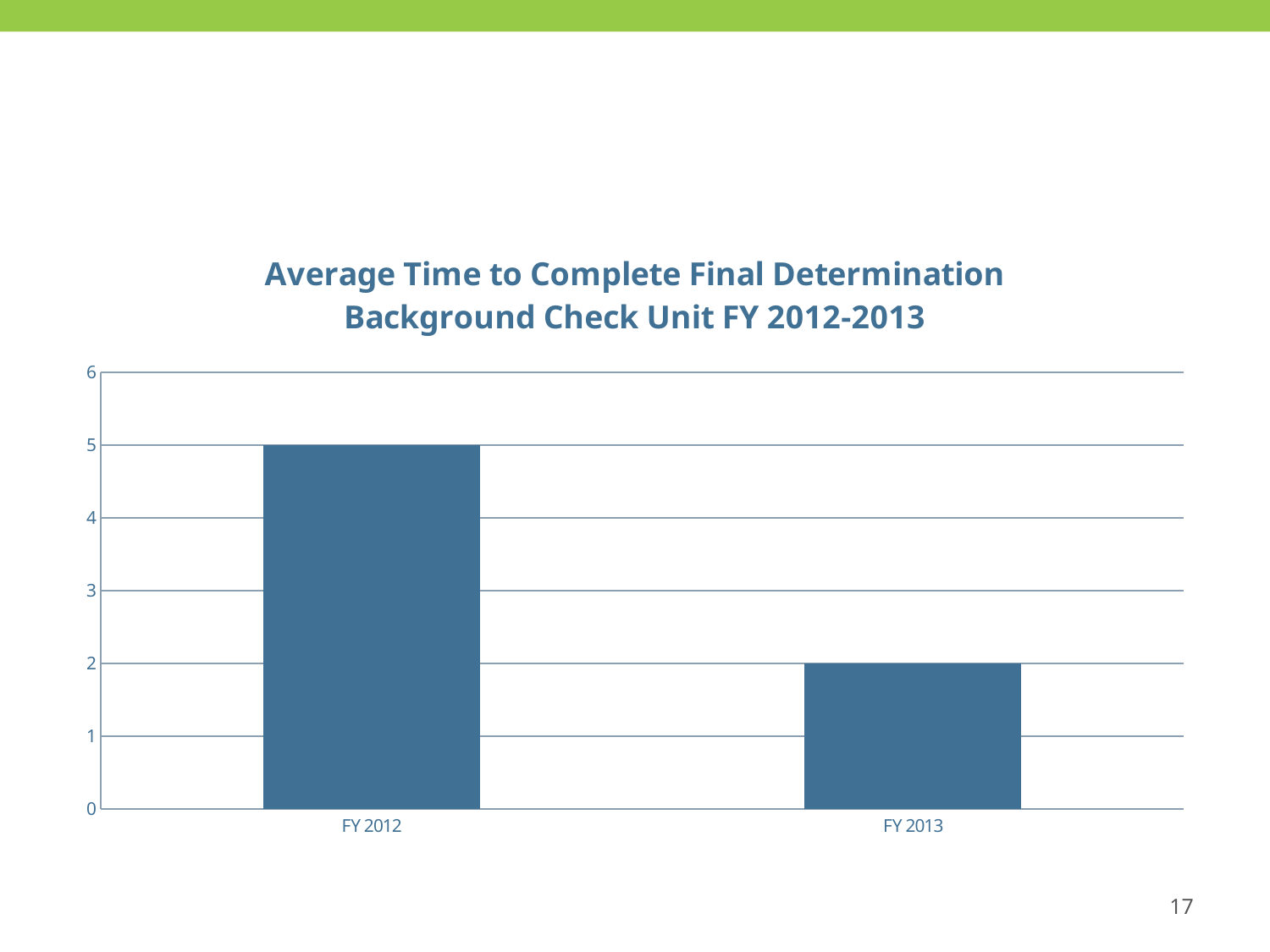
What is the value for FY 2012? 5 What is the title of the chart? Average Time to Complete Final Determination Background Check Unit FY 2012-2013 Which fiscal year has the highest value? FY 2012 How many categories are shown on the x axis? 2 What is the value for FY 2013? 2 What is the difference between the values for FY 2012 and FY 2013? 3 Which fiscal year has the lowest value? FY 2013 Do the values rise or fall from FY 2012 to FY 2013? fall Is the value for FY 2012 greater or less than 4? greater What kind of chart is shown on the slide? bar chart Which is larger, the value for FY 2012 or FY 2013? FY 2012 Is the value for FY 2013 greater or less than 3? less